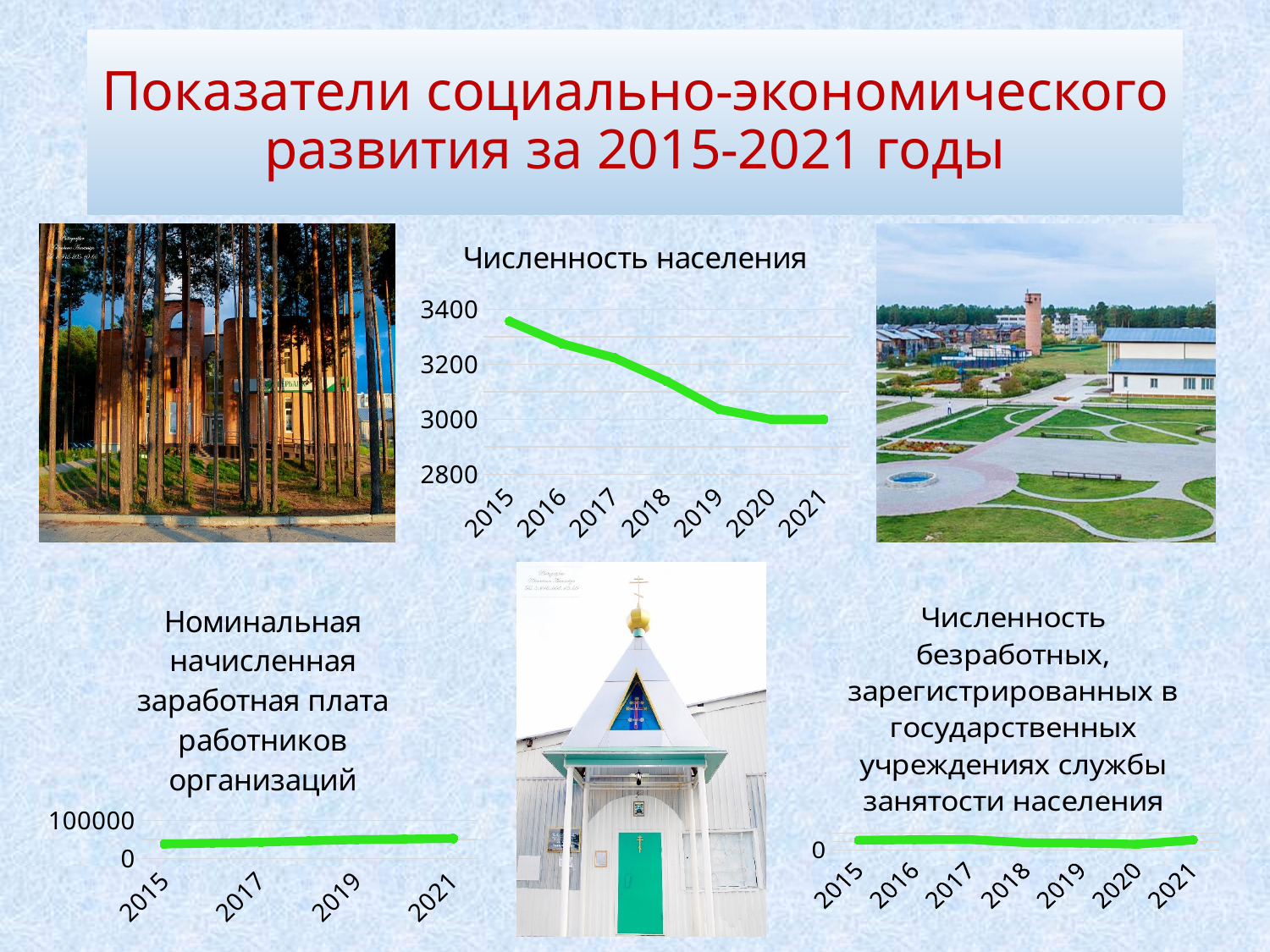
In the "Численность безработных, зарегистрированных в государственных учреждениях службы занятости населения" chart, how many years are shown on the x axis? 7 What kind of chart is the "Численность безработных, зарегистрированных в государственных учреждениях службы занятости населения" chart? line chart In the "Численность населения" chart, is the value for 2017 greater or less than 3000? greater In the "Численность населения" chart, which is larger, the value for 2016 or the value for 2019? 2016 What kind of chart is the "Номинальная начисленная заработная плата работников организаций" chart? line chart In the "Численность населения" chart, how many years are shown on the x axis? 7 In the "Численность населения" chart, is the value for 2015 greater or less than 3200? greater What kind of chart is the "Численность населения" chart? line chart In the "Численность населения" chart, is the value for 2019 greater or less than 3200? less In the "Численность населения" chart, which year has the highest value? 2015 In the "Численность населения" chart, do the values rise or fall from 2015 to 2021? fall